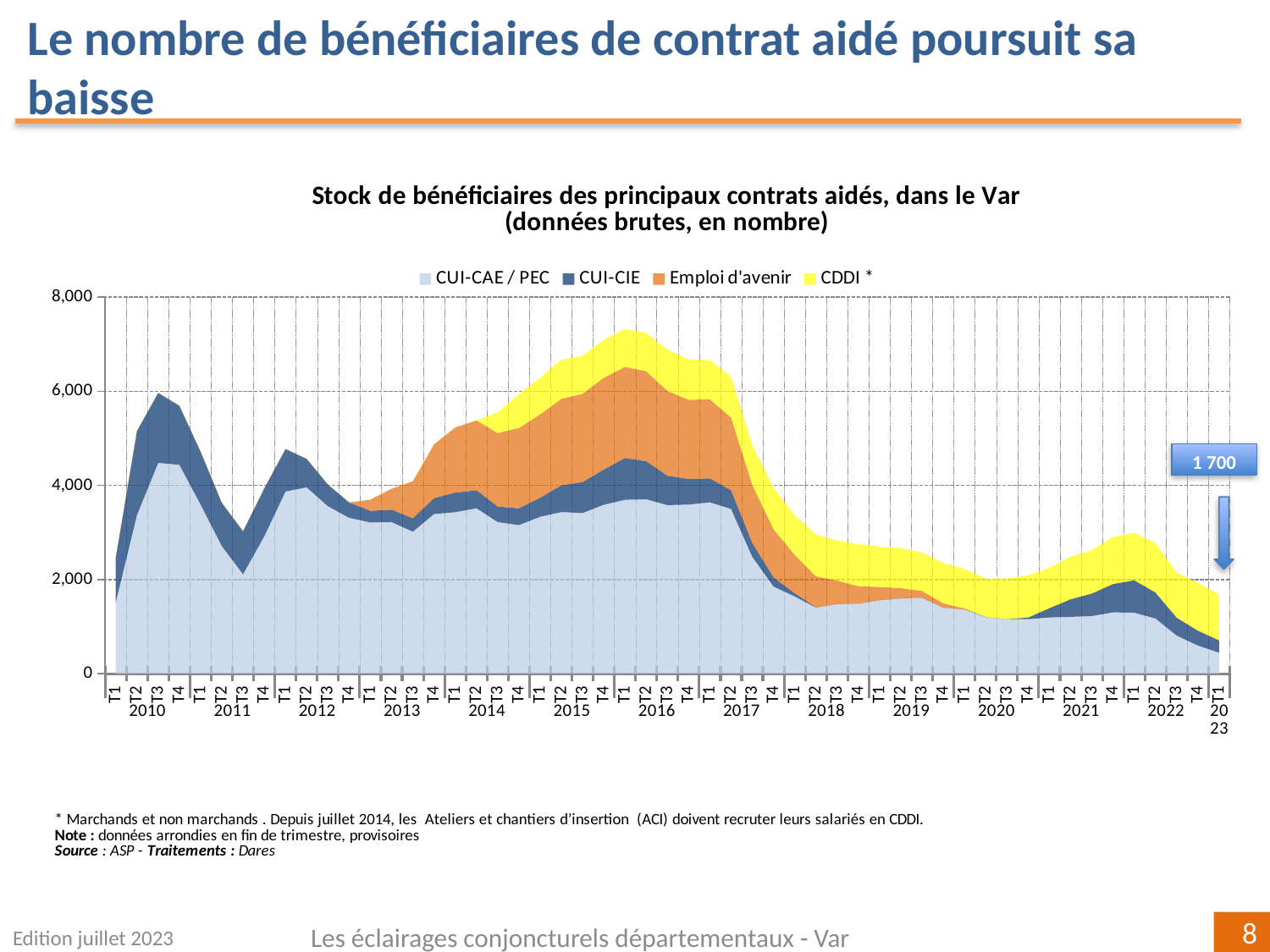
In which year does the total stock of beneficiaries reach its highest peak? 2016 What total value is shown in the callout label for T1 2023? 1 700 Which is larger, the total at T1 2016 or the total at T1 2023? T1 2016 How many series does the legend list? 4 Is the total stock of beneficiaries at T4 2022 greater or less than 4,000? less Does the total stock of beneficiaries rise or fall between 2017 and 2019? fall What is the title of the chart? Stock de bénéficiaires des principaux contrats aidés, dans le Var (données brutes, en nombre) Is the total stock of beneficiaries at T1 2020 greater or less than 4,000? less What kind of chart is shown on the slide? stacked area chart Is the value for CUI-CAE / PEC at T3 2010 greater or less than 4,000? greater Which series is shown in yellow in the legend? CDDI *